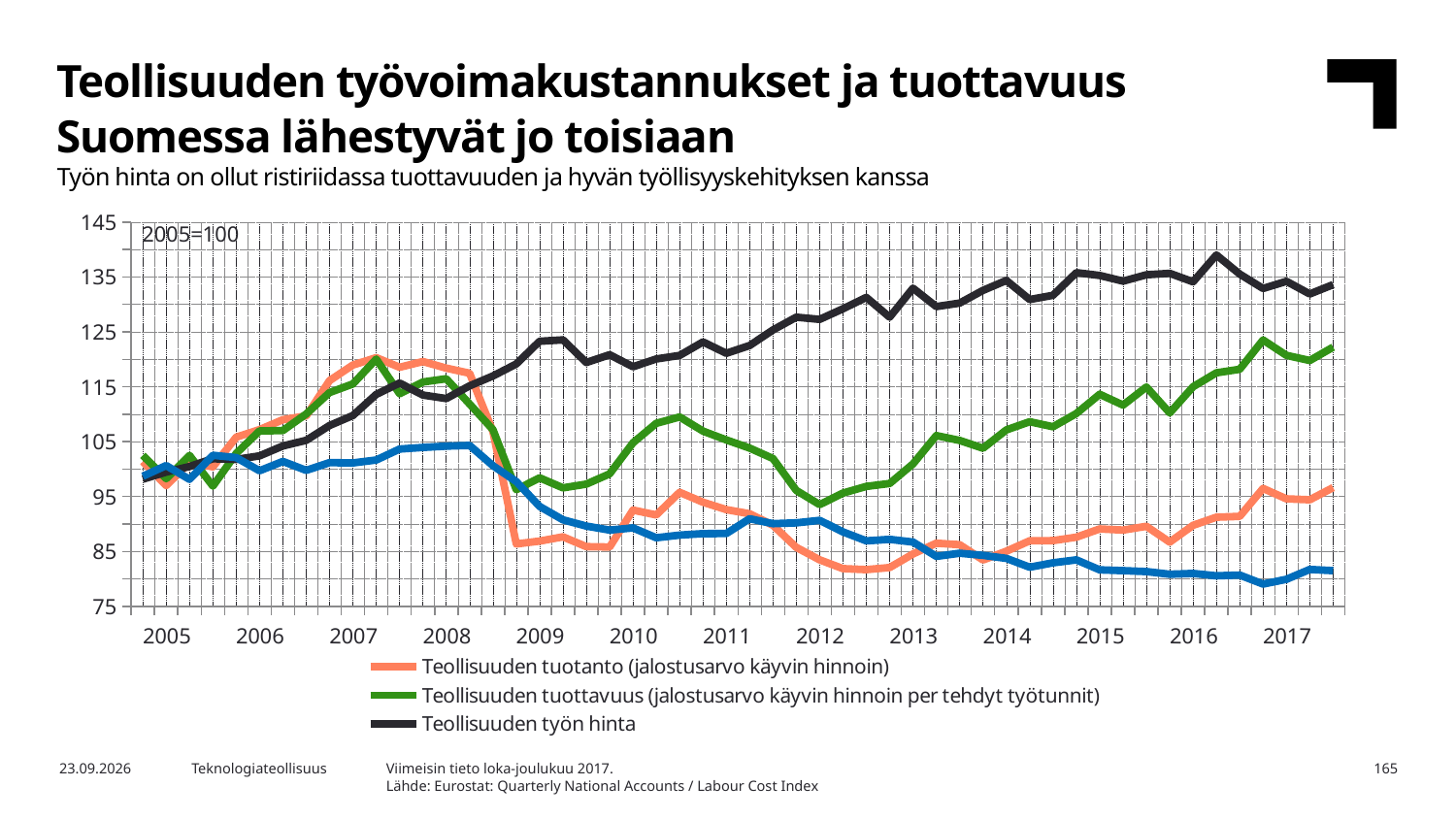
How many year labels are shown on the x axis? 13 What kind of chart is shown on the slide? line chart At the end of 2017, which is higher: Teollisuuden tuottavuus or Teollisuuden tuotanto? Teollisuuden tuottavuus Does Teollisuuden työn hinta generally rise or fall from 2005 to 2017? rise Is the value for Teollisuuden työn hinta at the end of 2017 greater or less than 125? greater What base-year index note is printed in the top-left corner of the plot area? 2005=100 What colour is the line for Teollisuuden työn hinta? black Is the value for Teollisuuden työn hinta at the start of 2009 greater or less than 115? greater Does Teollisuuden tuotanto rise or fall between 2008 and 2009? fall Is the value for Teollisuuden tuottavuus at the start of 2012 greater or less than 105? less How many series does the chart legend list? 3